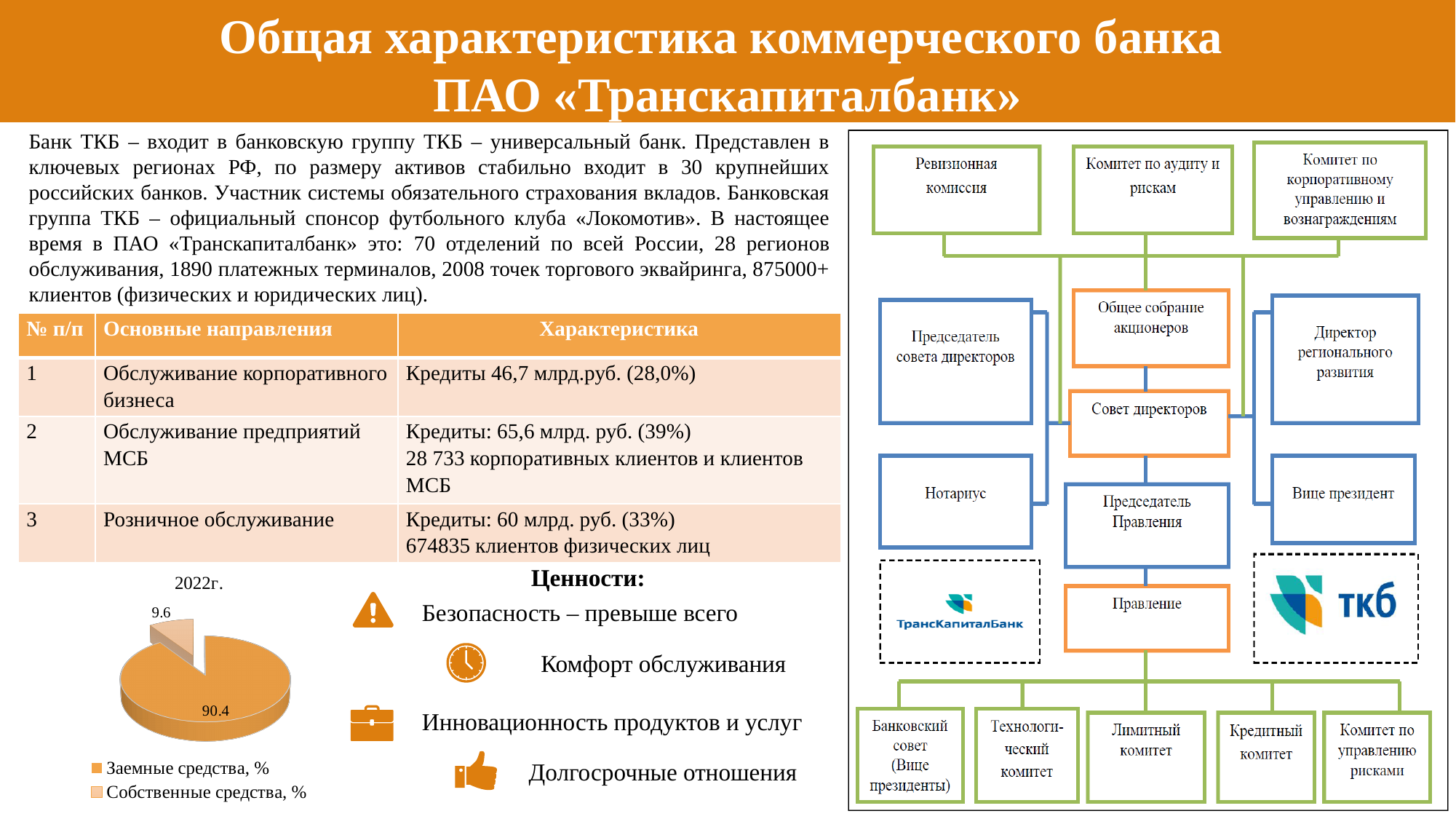
Which slice of the pie chart is the smallest? Собственные средства, % What share of the pie does the Собственные средства, % slice represent? 9.6% How many slices does the pie chart have? 2 Which slice of the pie chart is the largest? Заемные средства, % How many entries does the legend of the pie chart list? 2 What is the value for Собственные средства, % in the pie chart? 9.6 Which is larger in the pie chart: Заемные средства, % or Собственные средства, %? Заемные средства, % What is the difference between the values for Заемные средства, % and Собственные средства, % in the pie chart? 80.8 What is the value for Заемные средства, % in the pie chart? 90.4 What is the total of the two values shown in the pie chart? 100 What kind of chart is shown at the bottom left of the slide? pie chart What is the title of the pie chart? 2022г.